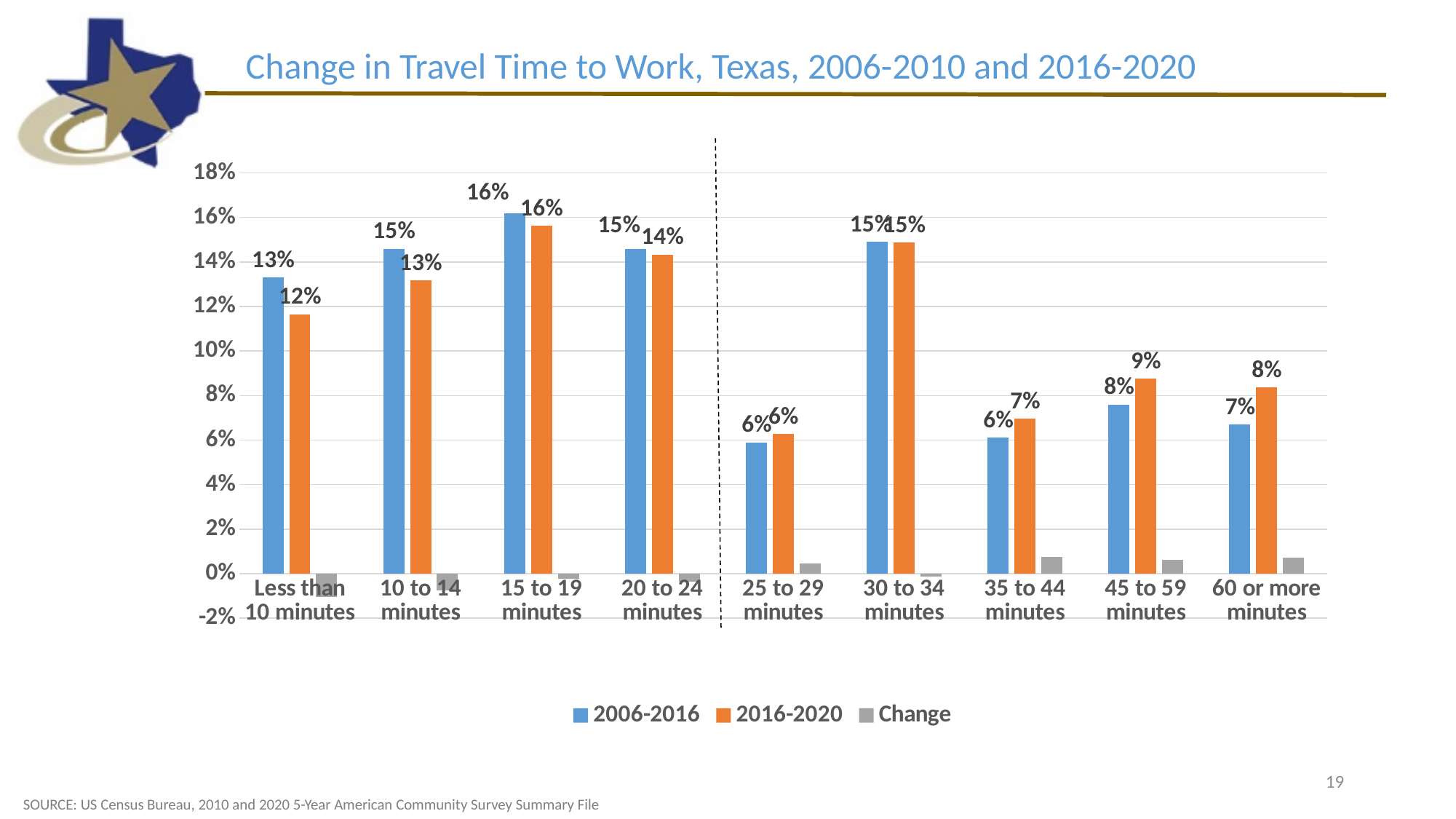
For Less than 10 minutes, which series has the larger value, 2006-2016 or 2016-2020? 2006-2016 What is the 2006-2016 value for Less than 10 minutes? 13% What kind of chart is shown on the slide? bar chart Is the Change value for 35 to 44 minutes greater or less than 2%? less How many series does the legend list? 3 How many travel time categories are shown on the x axis? 9 What is the 2016-2020 value for 45 to 59 minutes? 9% Which travel time category has the highest 2006-2016 value? 15 to 19 minutes For 10 to 14 minutes, how much higher is the 2006-2016 value than the 2016-2020 value? 2% For 60 or more minutes, which series has the larger value, 2006-2016 or 2016-2020? 2016-2020 What is the 2016-2020 value for 35 to 44 minutes? 7% Which travel time category has the lowest 2016-2020 value? 25 to 29 minutes